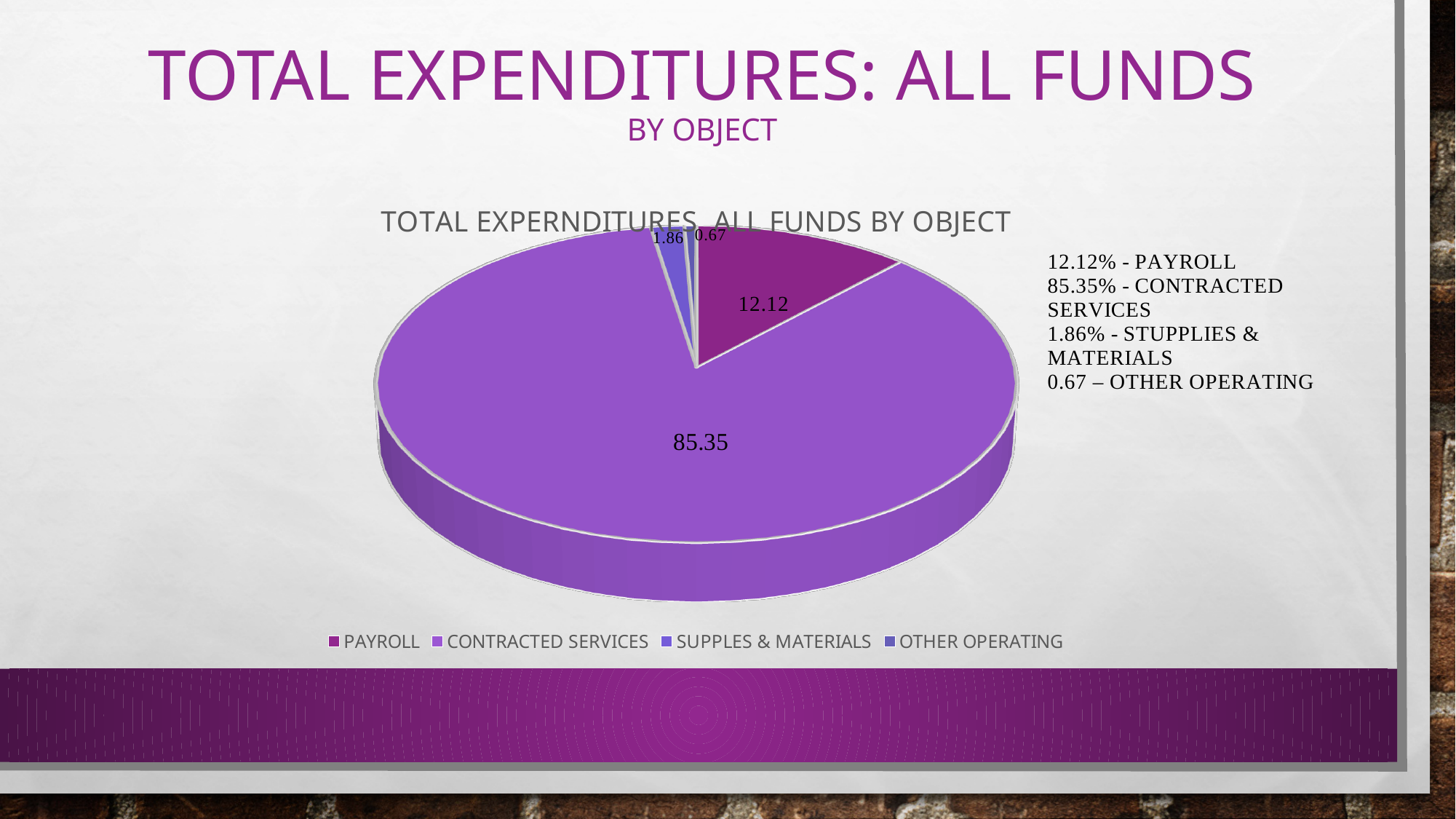
What is the difference between the CONTRACTED SERVICES value and the PAYROLL value? 73.23 Which category has the smallest slice of the pie? OTHER OPERATING Which legend entry is listed first? PAYROLL What is the data label for the SUPPLES & MATERIALS slice? 1.86 What is the data label for the CONTRACTED SERVICES slice? 85.35 Which is larger, the PAYROLL slice or the SUPPLES & MATERIALS slice? PAYROLL How many categories does the pie chart show? 4 What is the data label for the PAYROLL slice? 12.12 What is the title of the chart? TOTAL EXPERNDITURES, ALL FUNDS BY OBJECT Which category has the largest slice of the pie? CONTRACTED SERVICES What is the data label for the OTHER OPERATING slice? 0.67 What type of chart is shown on the slide? Pie chart